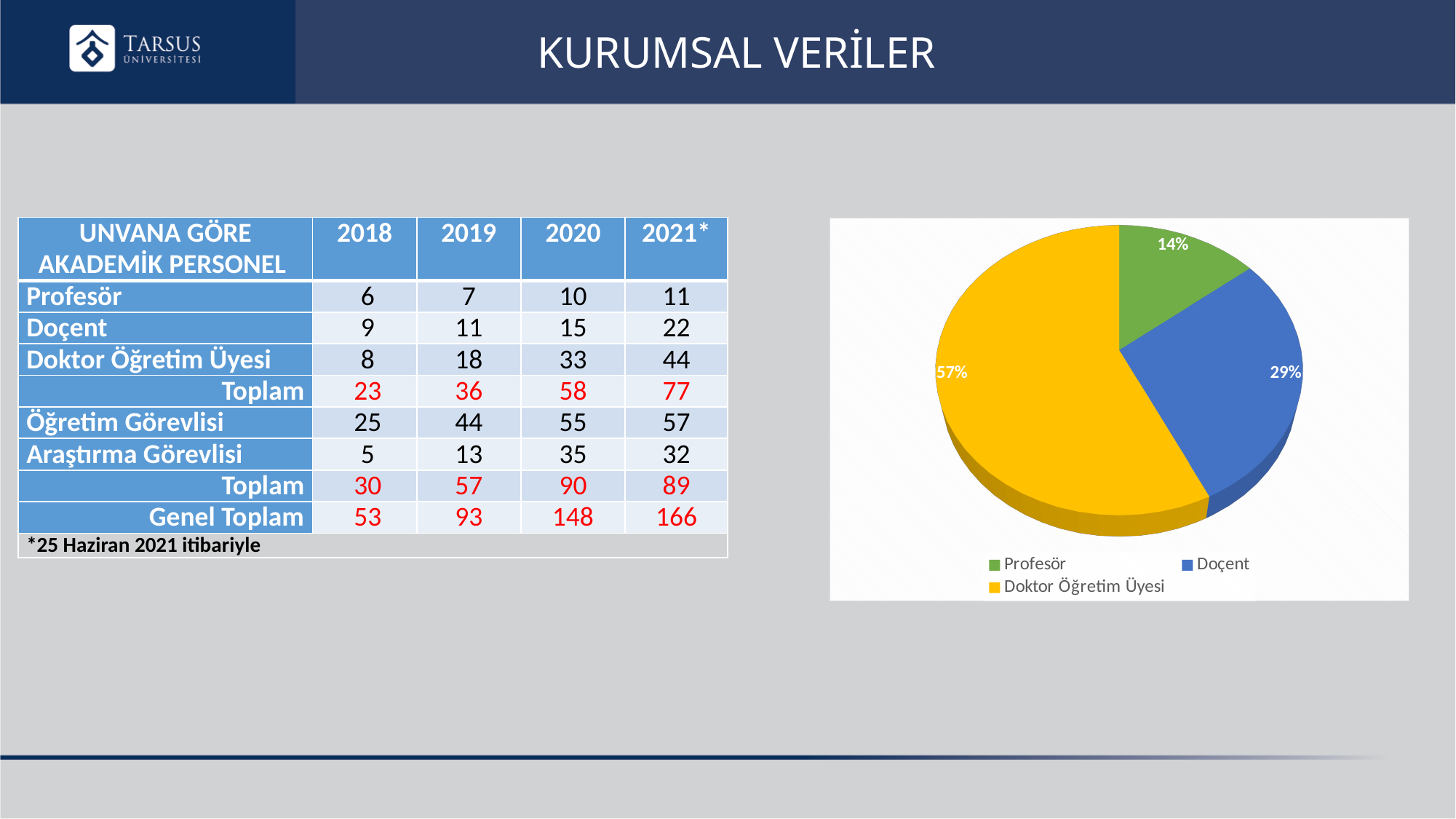
Which category has the smallest slice in the pie chart? Profesör What colour is the Doktor Öğretim Üyesi slice in the pie chart? yellow In the pie chart, what share is shown for Doktor Öğretim Üyesi? 57% What colour is the Profesör slice in the pie chart? green Which category has the largest slice in the pie chart? Doktor Öğretim Üyesi In the pie chart, what share is shown for Profesör? 14% In the pie chart, what is the difference in percentage points between the Doçent slice and the Profesör slice? 15 In the pie chart, what is the difference in percentage points between the Doktor Öğretim Üyesi slice and the Doçent slice? 28 In the pie chart, what share is shown for Doçent? 29% In the pie chart, which is larger: the Doçent slice or the Profesör slice? Doçent How many slices does the pie chart have? 3 What kind of chart is shown on the right side of the slide? pie chart